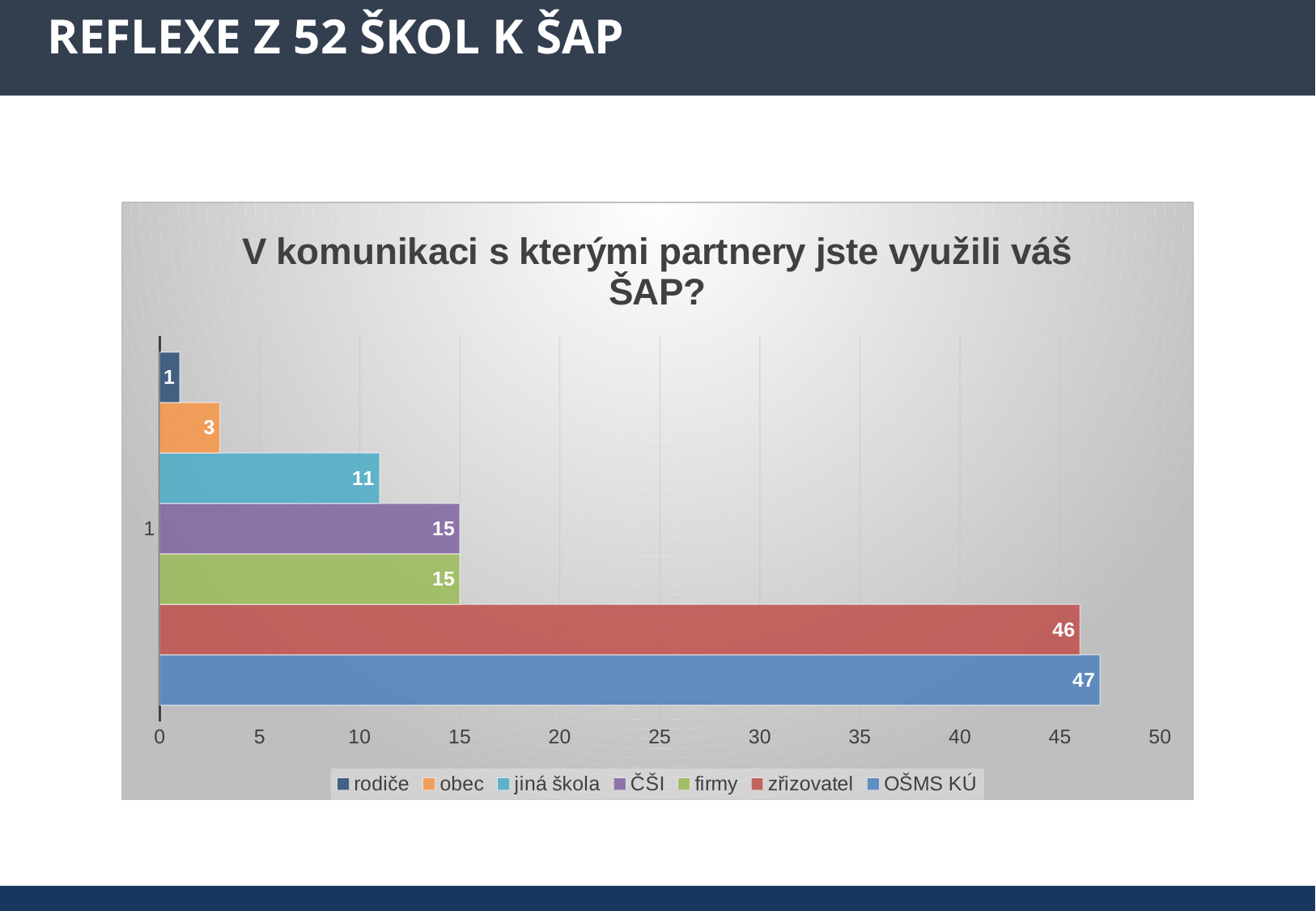
What kind of chart is shown? bar chart Which is larger, the value for jiná škola or the value for obec? jiná škola Which partner has the lowest value? rodiče How many series does the legend list? 7 Which partner has the highest value? OŠMS KÚ What value is shown for zřizovatel? 46 What is the difference between the values for OŠMS KÚ and zřizovatel? 1 What value is shown for jiná škola? 11 What value is shown for obec? 3 What is the title of the chart? V komunikaci s kterými partnery jste využili váš ŠAP? What value is shown for OŠMS KÚ? 47 What is the difference between the values for ČŠI and jiná škola? 4